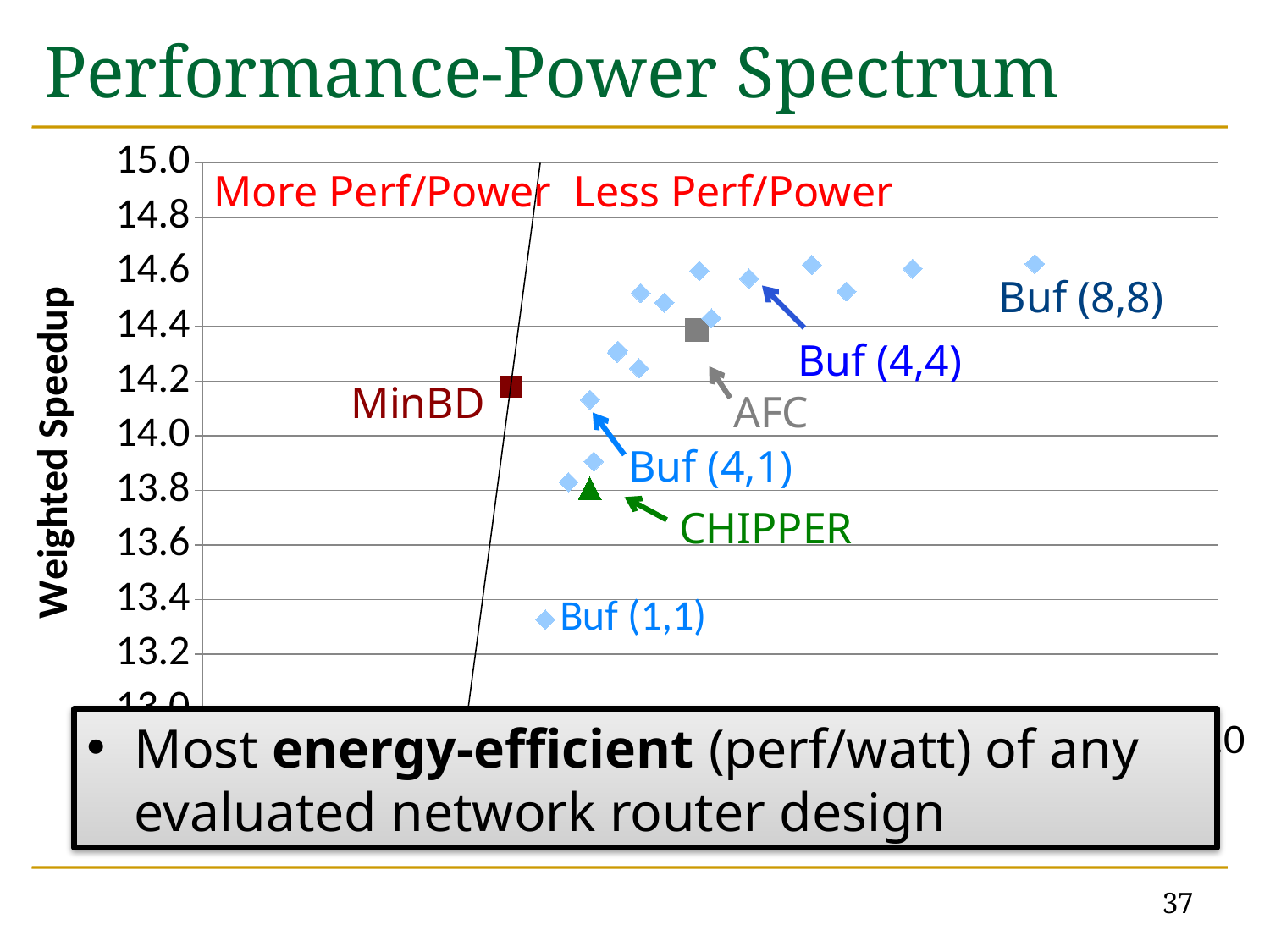
Which has the higher weighted speedup, Buf (8,8) or Buf (1,1)? Buf (8,8) What is the title of the vertical axis? Weighted Speedup Is the weighted speedup for AFC greater or less than 14.2? greater Is the weighted speedup for Buf (1,1) greater or less than 13.4? less Which labeled design has the lowest weighted speedup? Buf (1,1) Is the weighted speedup for Buf (8,8) greater or less than 14.4? greater What kind of chart is shown on the slide? scatter chart Which has the higher weighted speedup, AFC or MinBD? AFC Which design is marked with a green triangle? CHIPPER Which has the higher weighted speedup, MinBD or CHIPPER? MinBD